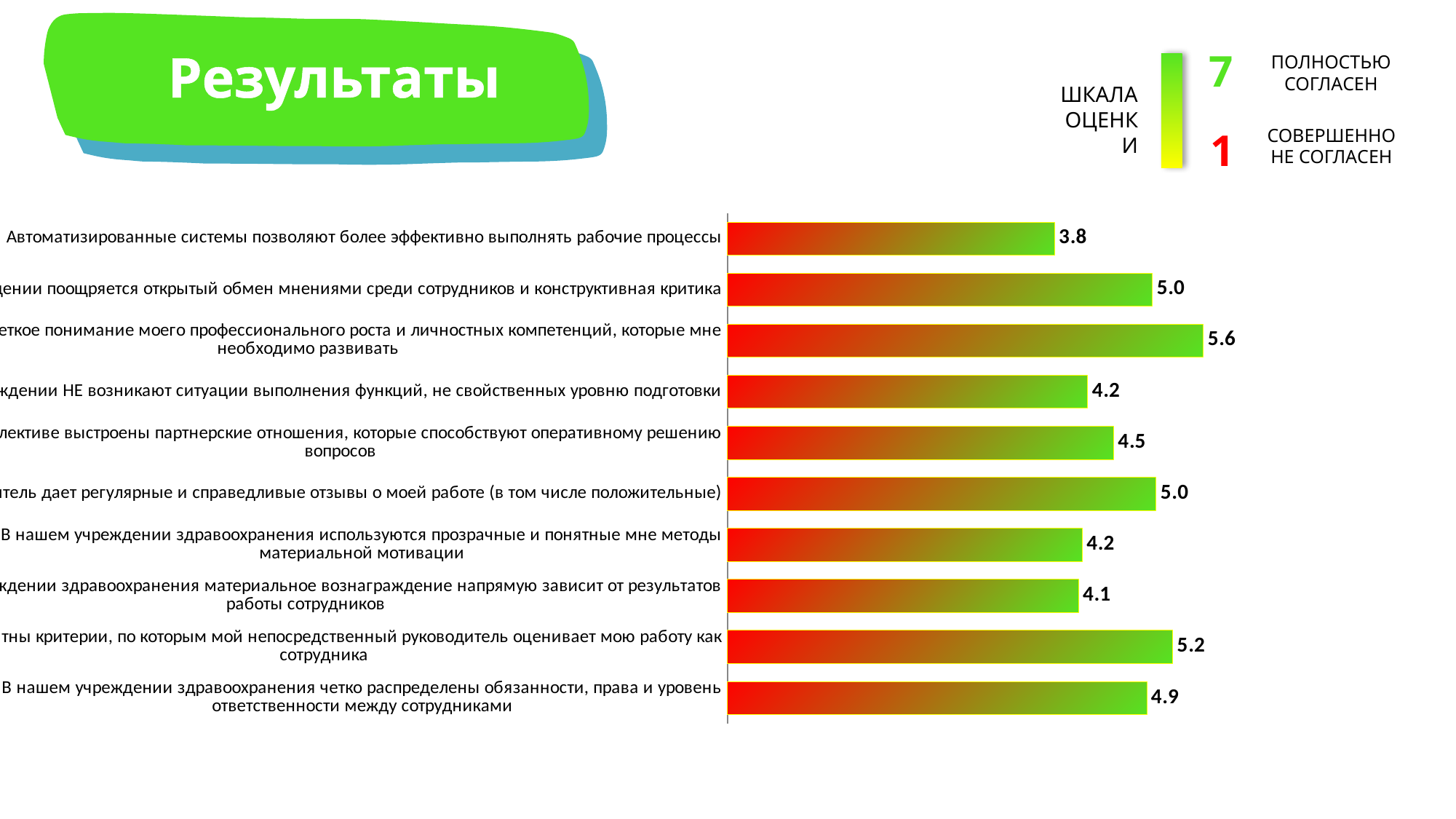
What is the difference between the highest value (5.6) and the lowest value (3.8) in the chart? 1.8 What kind of chart is shown on the slide? bar chart According to the rating scale legend, what score means "ПОЛНОСТЬЮ СОГЛАСЕН"? 7 What is the difference between the value of the bottom bar (4.9) and the value of the top bar (3.8)? 1.1 Which category has the lowest value in the chart? Автоматизированные системы позволяют более эффективно выполнять рабочие процессы What is the value for "Автоматизированные системы позволяют более эффективно выполнять рабочие процессы"? 3.8 What is the value of the third bar from the top? 5.6 How many bars (categories) does the chart contain? 10 Which is larger: the value for "В нашем учреждении здравоохранения четко распределены обязанности, права и уровень ответственности между сотрудниками" or the value for "Автоматизированные системы позволяют более эффективно выполнять рабочие процессы"? В нашем учреждении здравоохранения четко распределены обязанности, права и уровень ответственности между сотрудниками What is the value for "В нашем учреждении здравоохранения используются прозрачные и понятные мне методы материальной мотивации"? 4.2 What is the highest value shown in the chart? 5.6 What is the value for "В нашем учреждении здравоохранения четко распределены обязанности, права и уровень ответственности между сотрудниками"? 4.9